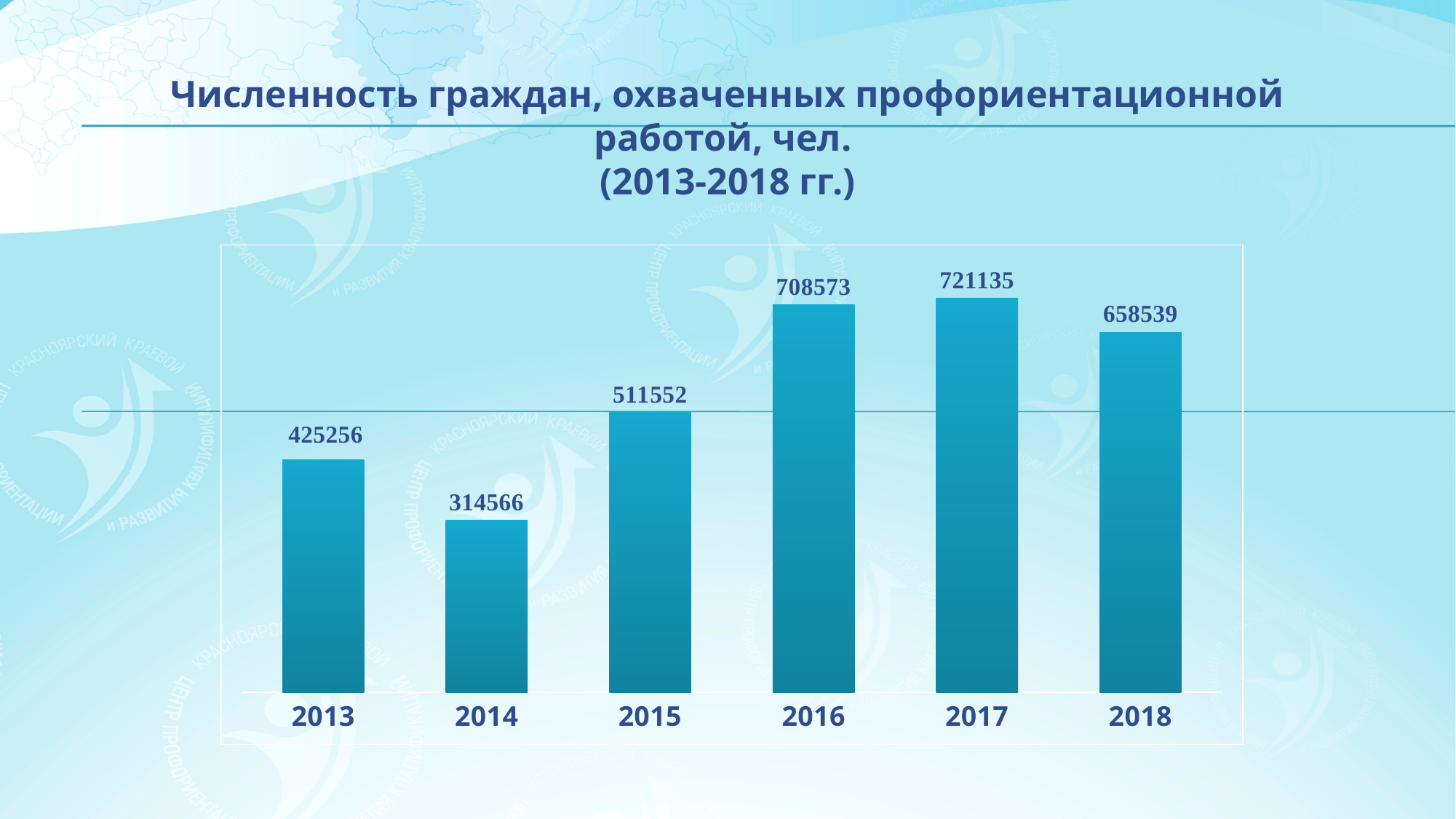
What is the value for 2018? 658539 Which is larger, the value for 2013 or the value for 2018? 2018 What is the difference between the values for 2015 and 2014? 196986 Which year has the lowest value? 2014 Which year has the highest value? 2017 How many years are shown on the x axis? 6 Do the values rise or fall from 2014 to 2017? rise What is the title of the chart? Численность граждан, охваченных профориентационной работой, чел. (2013-2018 гг.) What is the value for 2016? 708573 What kind of chart is this? bar chart What is the difference between the values for 2017 and 2016? 12562 What is the value for 2013? 425256